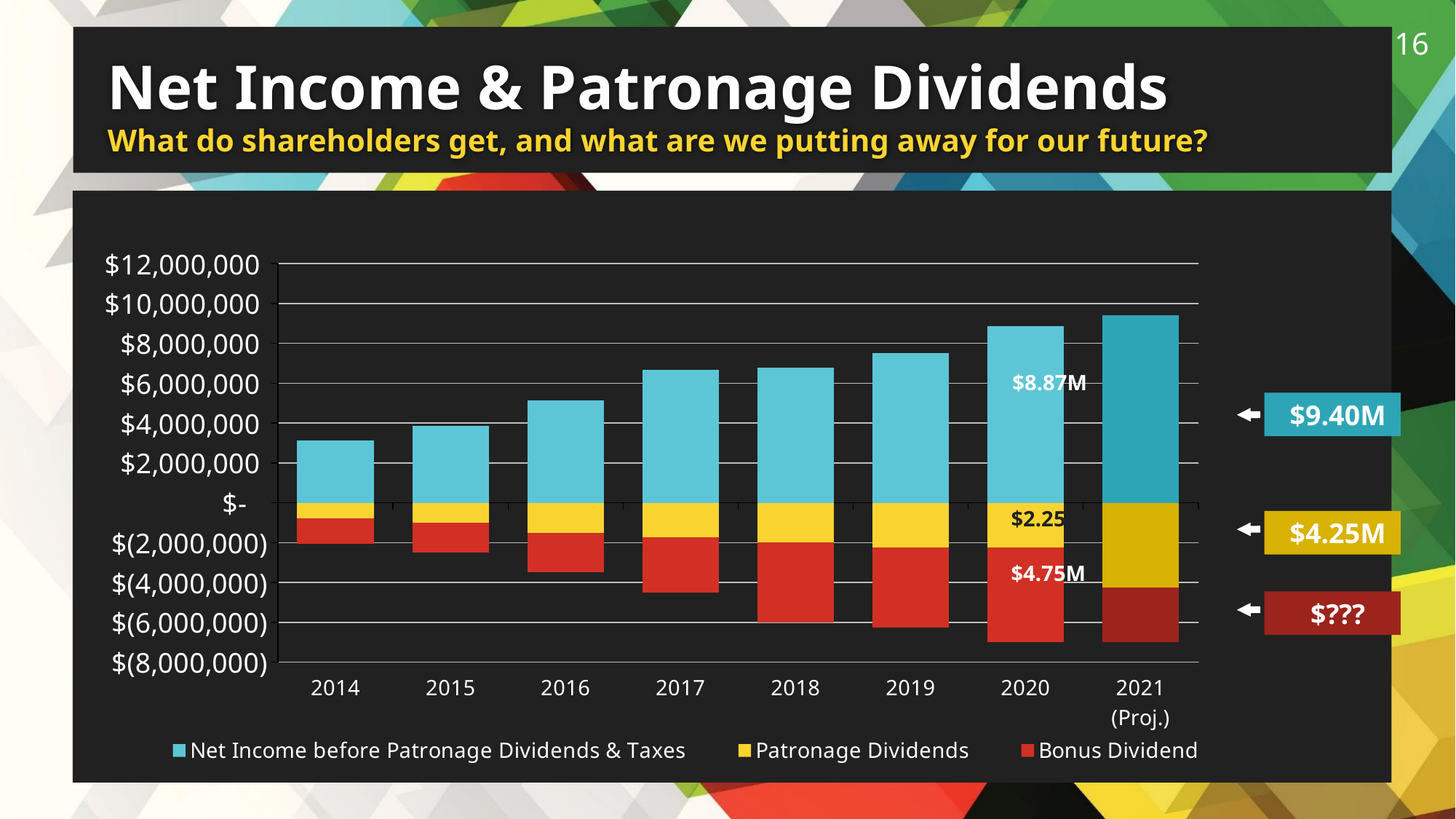
Is the Net Income before Patronage Dividends & Taxes for 2014 greater or less than $4,000,000? less What is the Net Income before Patronage Dividends & Taxes for 2020? $8.87M How many years are shown on the x axis of the chart? 8 Is the Net Income before Patronage Dividends & Taxes for 2019 greater or less than $6,000,000? greater What is the Bonus Dividend value labelled for 2020? $4.75M What is the Patronage Dividends value labelled for 2021 (Proj.)? $4.25M Which year has the highest Net Income before Patronage Dividends & Taxes? 2021 (Proj.) Which year has the lowest Net Income before Patronage Dividends & Taxes? 2014 What is the difference between the Net Income before Patronage Dividends & Taxes for 2021 (Proj.) and 2020? $0.53M What label is shown for the Bonus Dividend in 2021 (Proj.)? $??? What is the Net Income before Patronage Dividends & Taxes for 2021 (Proj.)? $9.40M How many series does the legend list? 3